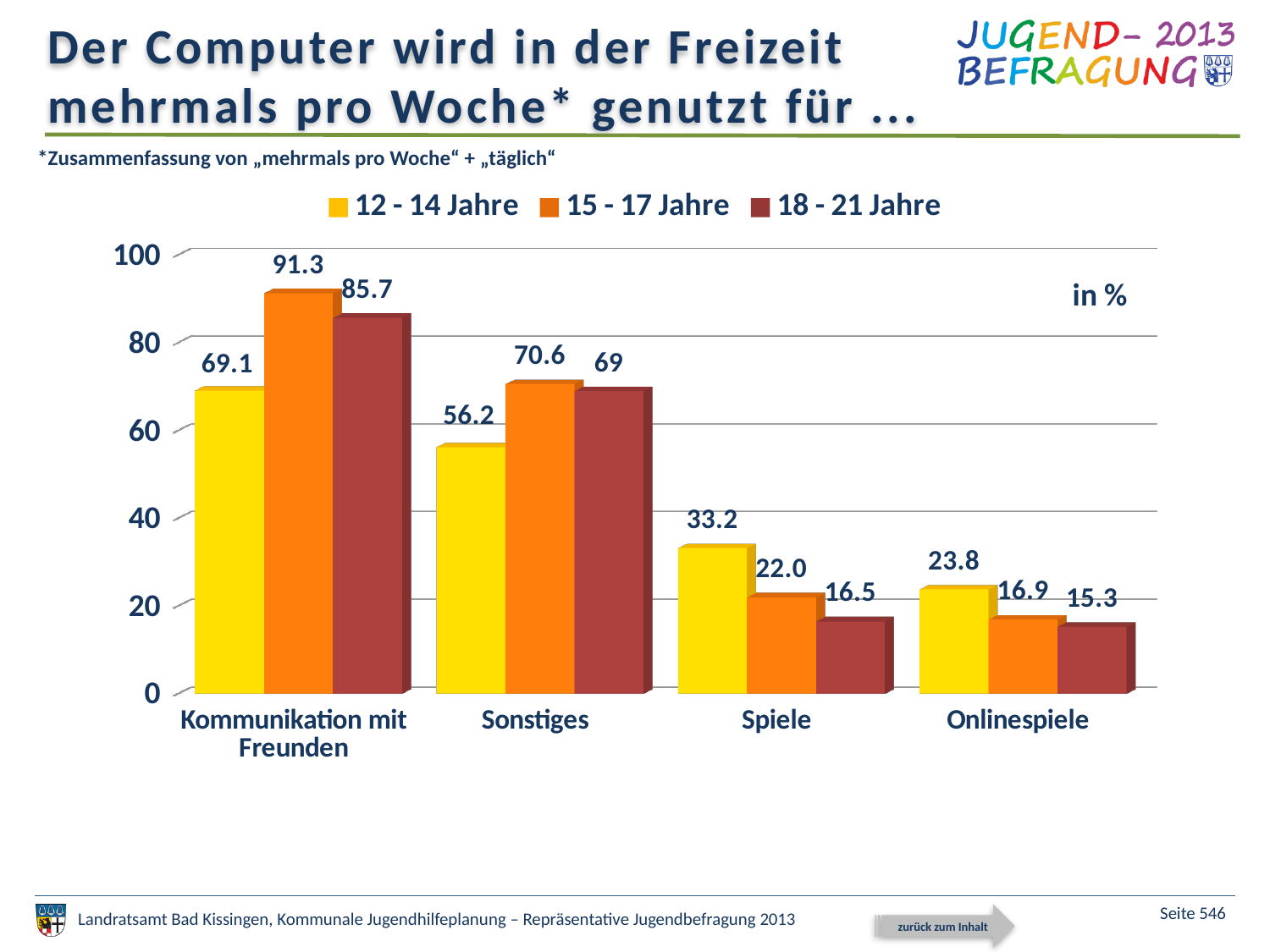
What is the difference between the 15 - 17 Jahre and 12 - 14 Jahre values for 'Sonstiges'? 14.4 What unit is indicated for the values in the chart? in % Which category has the lowest value in the 18 - 21 Jahre series? Onlinespiele What kind of chart is shown on the slide? bar chart Which category has the highest value in the 12 - 14 Jahre series? Kommunikation mit Freunden Is the 12 - 14 Jahre value for 'Onlinespiele' greater or less than 20? greater How many series does the legend list? 3 Which is larger for 'Spiele': the 15 - 17 Jahre value or the 18 - 21 Jahre value? 15 - 17 Jahre What is the value for 'Onlinespiele' in the 18 - 21 Jahre series? 15.3 What is the value for 'Spiele' in the 12 - 14 Jahre series? 33.2 How many categories are shown on the x axis? 4 What is the value for 'Kommunikation mit Freunden' in the 15 - 17 Jahre series? 91.3